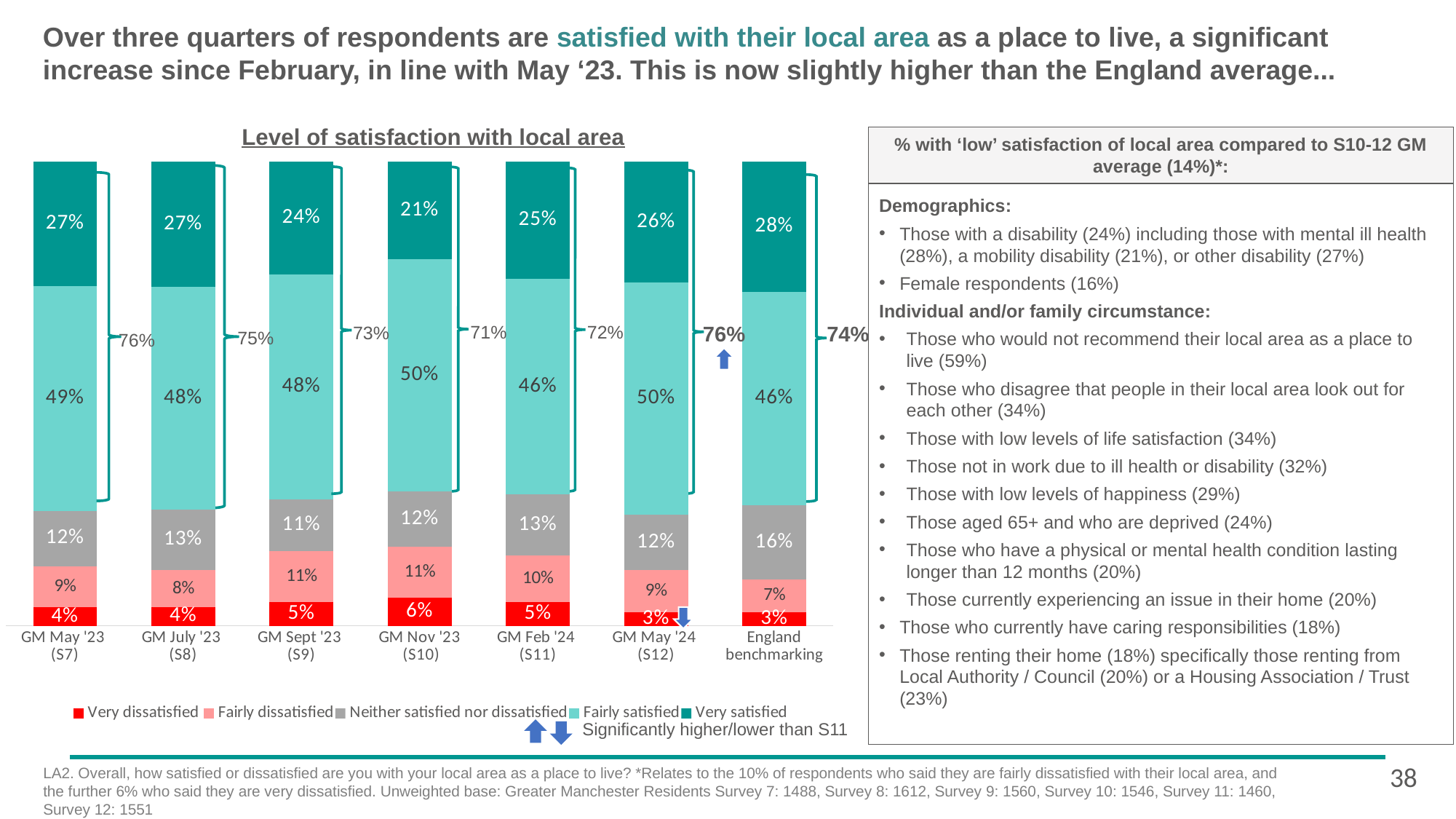
How many bars (categories) are shown in the 'Level of satisfaction with local area' chart? 7 What type of chart is used to show the level of satisfaction with local area? Stacked bar chart Which is larger: the 'Fairly dissatisfied' value for GM Sept '23 (S9) or for England benchmarking? GM Sept '23 (S9) How many series does the legend of the 'Level of satisfaction with local area' chart list? 5 What is the 'Very satisfied' value for England benchmarking? 28% Which category has the lowest 'Very satisfied' value? GM Nov '23 (S10) What is the 'Very dissatisfied' value for GM Nov '23 (S10)? 6% What is the combined 'Fairly satisfied' and 'Very satisfied' total shown for GM May '24 (S12)? 76% What is the 'Neither satisfied nor dissatisfied' value for England benchmarking? 16% What is the difference between the 'Fairly satisfied' values for GM May '24 (S12) and GM Feb '24 (S11)? 4% Which category has the highest 'Very dissatisfied' value? GM Nov '23 (S10) What is the title of the chart on the slide? Level of satisfaction with local area